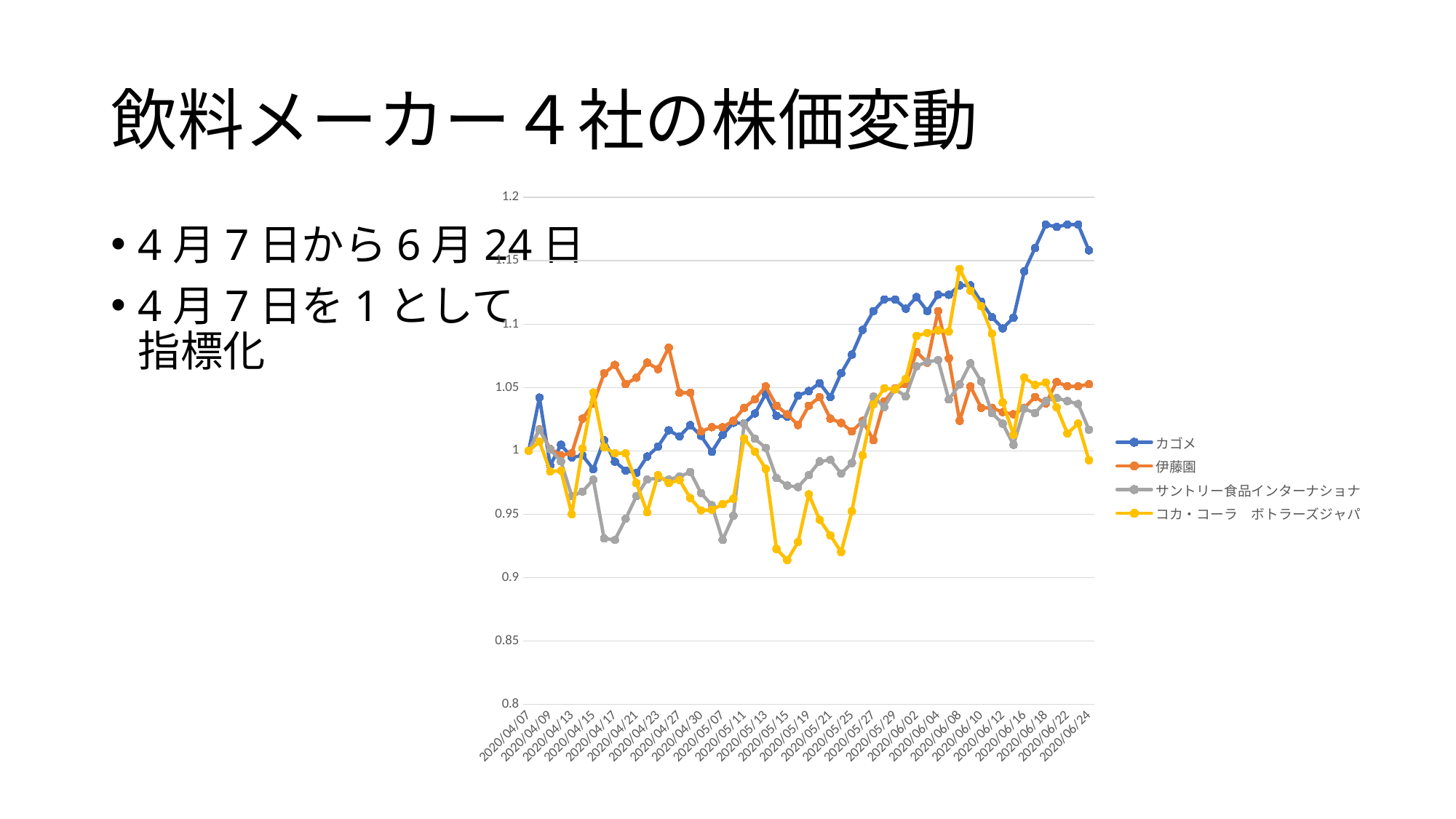
Is the value for サントリー食品インターナショナ on 2020/04/17 greater or less than 0.95? less On 2020/06/24, which is higher: カゴメ or コカ・コーラ ボトラーズジャパ? カゴメ What is the title of the slide containing the chart? 飲料メーカー４社の株価変動 On 2020/06/08, which is higher: コカ・コーラ ボトラーズジャパ or 伊藤園? コカ・コーラ ボトラーズジャパ Is the value for カゴメ on 2020/06/18 greater or less than 1.15? greater Is the value for コカ・コーラ ボトラーズジャパ on 2020/05/15 greater or less than 0.95? less What kind of chart is shown on the slide? line chart Which series is drawn in blue? カゴメ Which series reaches the lowest value anywhere on the chart? コカ・コーラ ボトラーズジャパ Which series reaches the highest value anywhere on the chart? カゴメ How many series does the legend list? 4